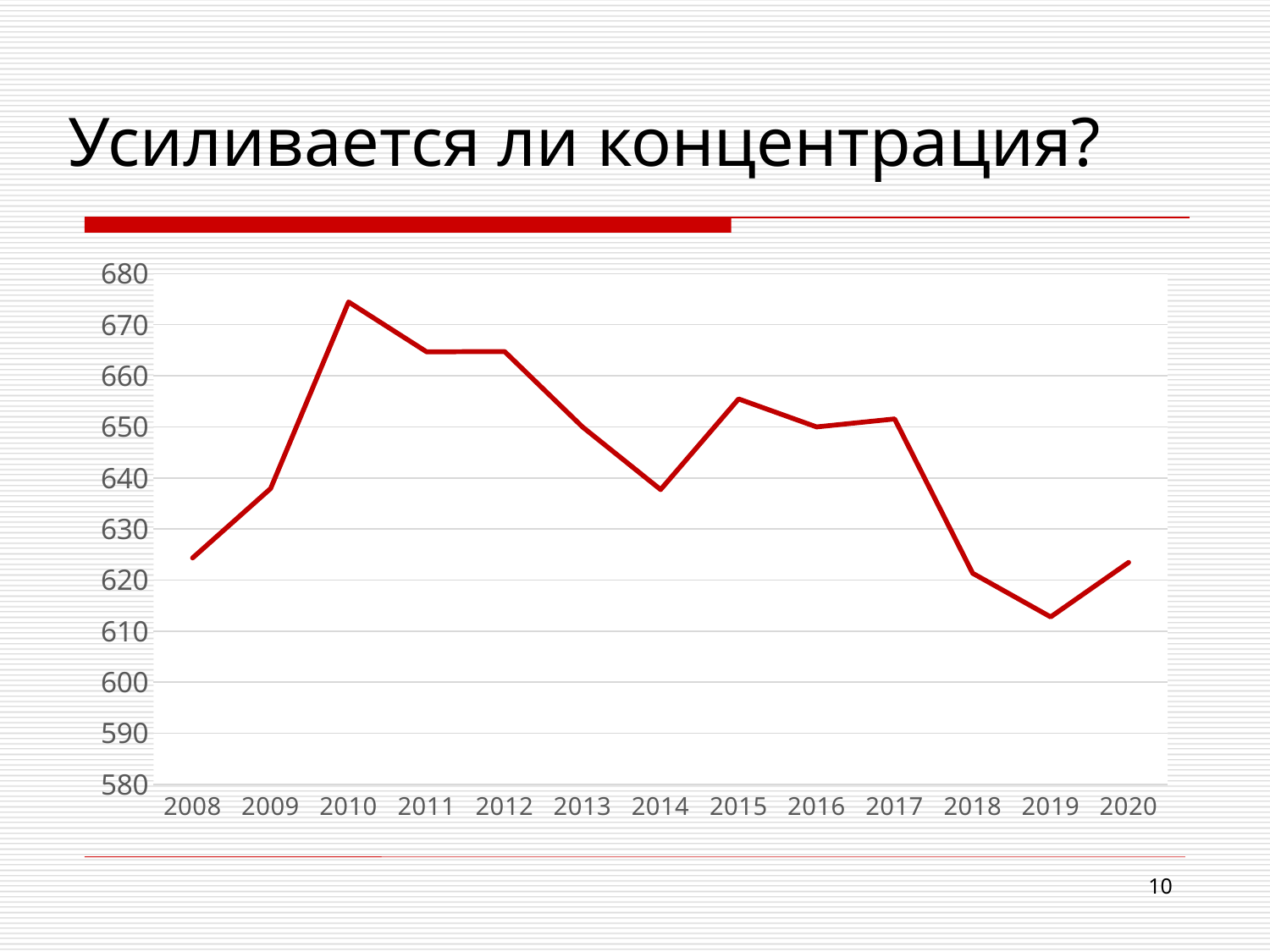
Is the value for 2010 greater or less than 670? greater In which year does the line reach its lowest value? 2019 Which year has the larger value, 2009 or 2018? 2009 Which year has the larger value, 2014 or 2015? 2015 Is the value for 2019 greater or less than 620? less How many years are plotted along the x axis? 13 Is the value for 2018 greater or less than 630? less In which year does the line reach its highest value? 2010 Does the line rise or fall from 2017 to 2019? fall What kind of chart is shown on the slide? line chart What is the title of the slide containing the chart? Усиливается ли концентрация?